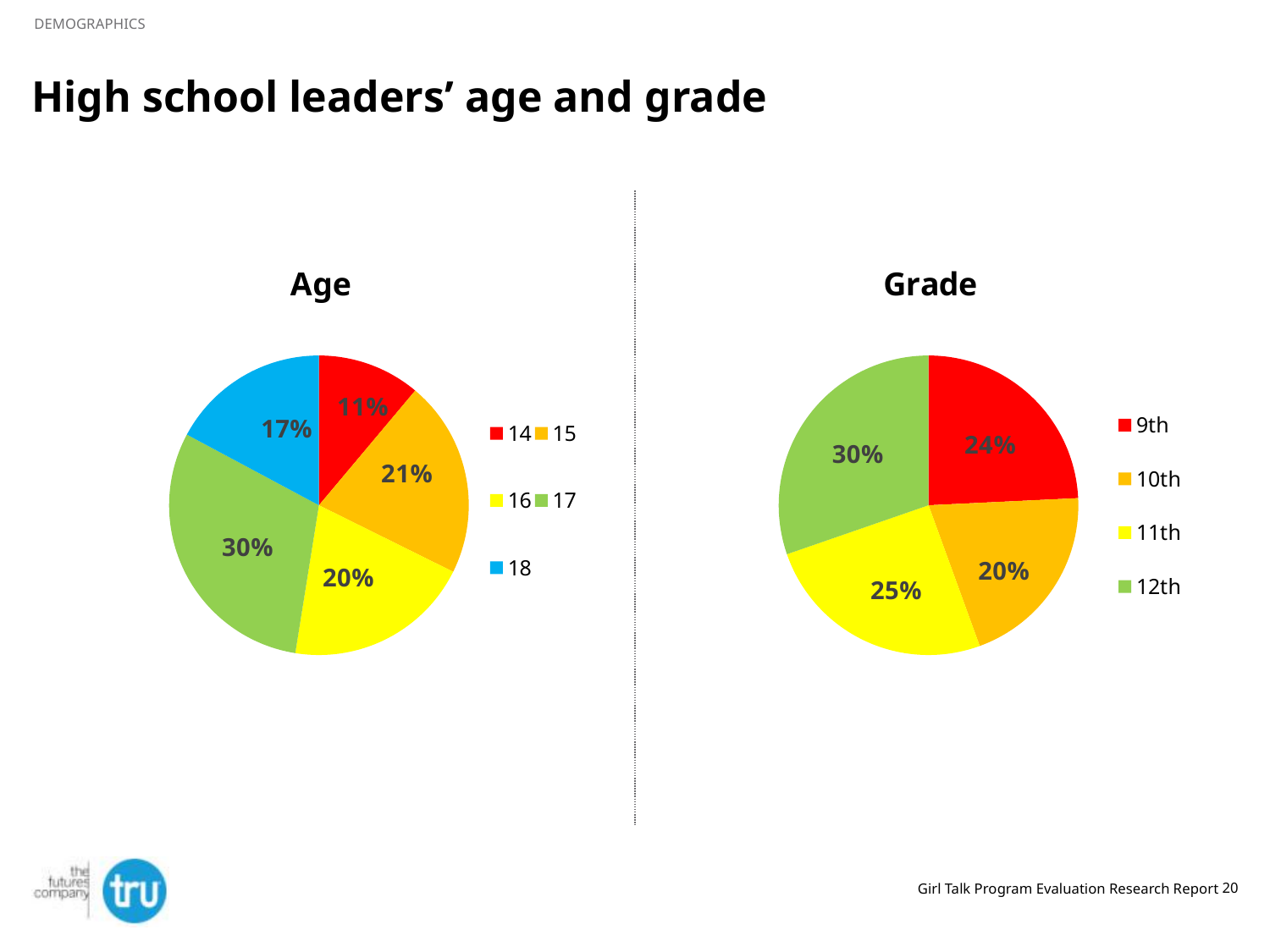
How many slices does the Grade chart have? 4 In the Grade chart, what percentage of high school leaders are in 9th grade? 24% In the Grade chart, what percentage of high school leaders are in 11th grade? 25% In the Age chart, which age has the smallest share? 14 What type of chart is the Age chart? Pie chart In the Age chart, which is larger, the share for 15 or the share for 16? 15 In the Grade chart, which grade has the largest share? 12th In the Grade chart, what is the difference between the share for 12th and the share for 10th? 10% In the Age chart, what is the difference between the share for 17 and the share for 18? 13% How many categories does the legend of the Age chart list? 5 In the Age chart, what percentage of high school leaders are 14? 11% In the Age chart, what percentage of high school leaders are 17? 30%